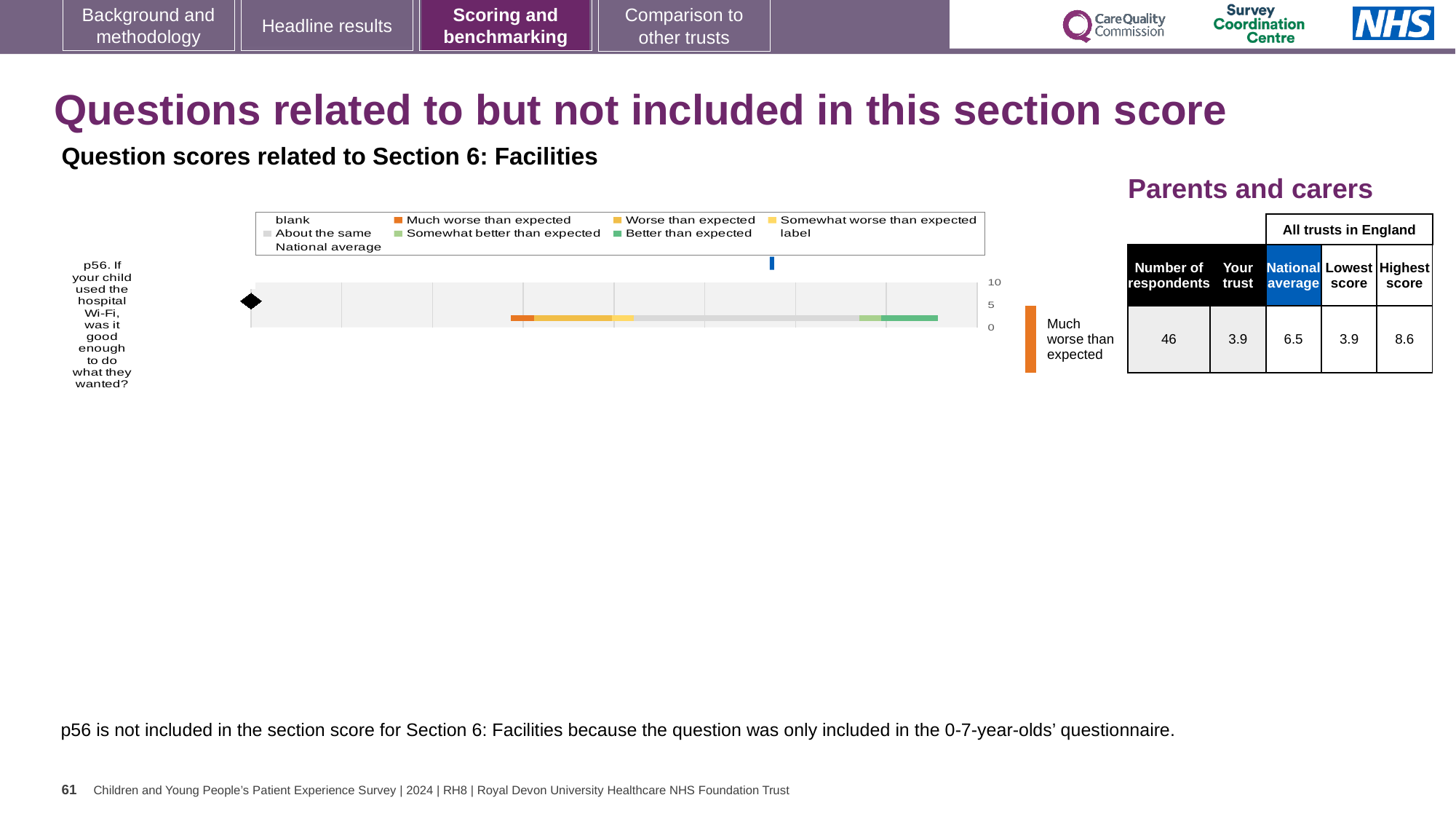
What kind of chart is shown on the slide? bar chart Is the Your trust marker for p56 positioned at a value greater or less than 5 on the axis? less How many questions (categories) are plotted on the chart? 1 Which benchmarking category does the trust's p56 score fall into? Much worse than expected What is the difference between the National average and the Your trust score for p56? 2.6 How many respondents answered p56? 46 What is the Lowest score among all trusts in England for p56? 3.9 What is the Highest score among all trusts in England for p56? 8.6 What is the National average score for p56? 6.5 What is the 'Your trust' score for p56? 3.9 Which is larger for p56, the Your trust score or the National average? National average Which question is plotted on the chart? p56. If your child used the hospital Wi-Fi, was it good enough to do what they wanted?